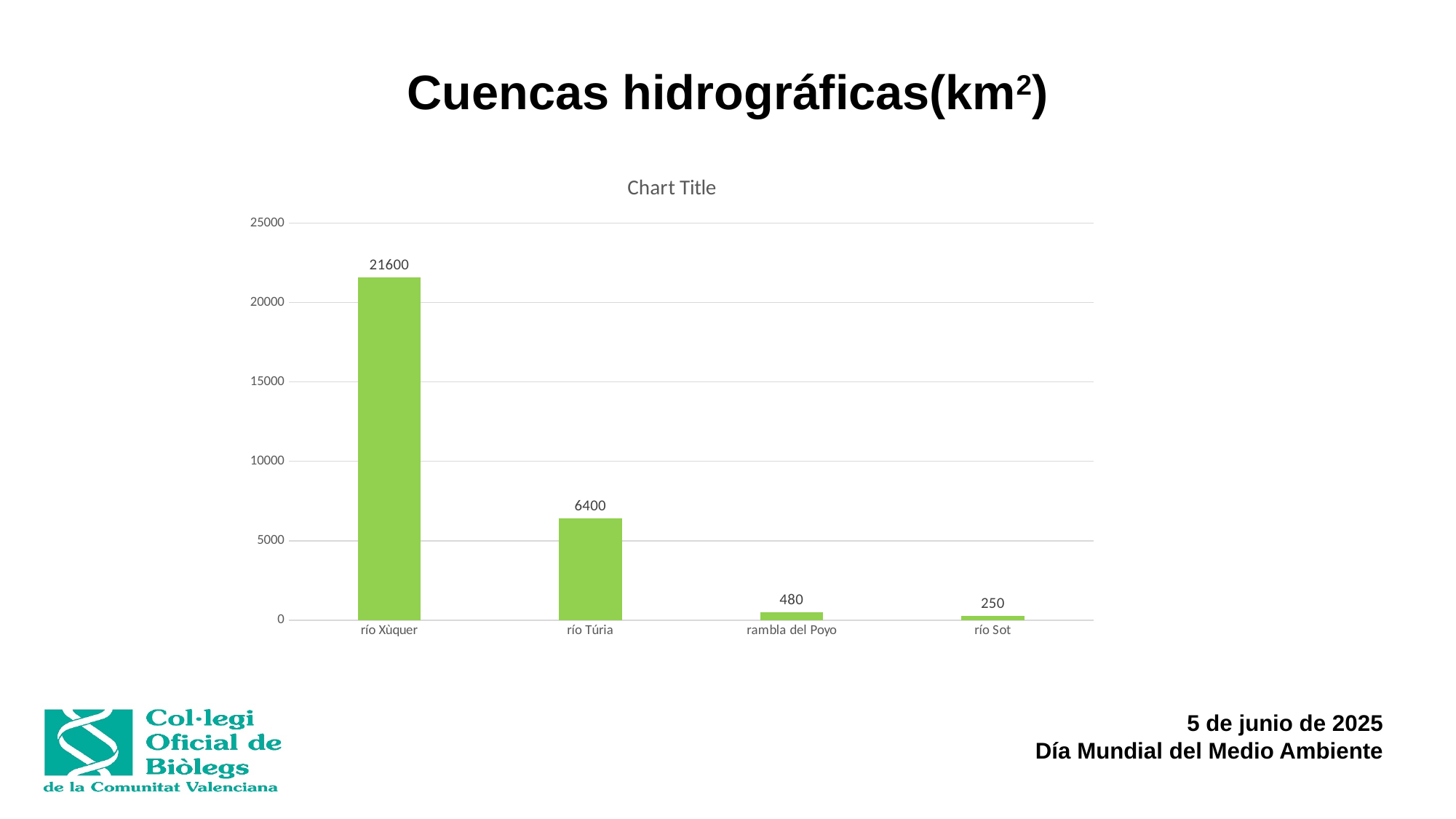
What kind of chart is shown on the slide? bar chart What is the difference between the values for río Xùquer and río Túria? 15200 What is the value for río Sot? 250 Which category has the lowest value? río Sot What is the value for rambla del Poyo? 480 Which is larger, the value for río Túria or the value for rambla del Poyo? río Túria Do the values rise or fall from left to right along the x axis? fall What is the value for río Túria? 6400 What is the difference between the values for rambla del Poyo and río Sot? 230 How many categories are shown on the chart? 4 Which category has the highest value? río Xùquer What is the value for río Xùquer? 21600